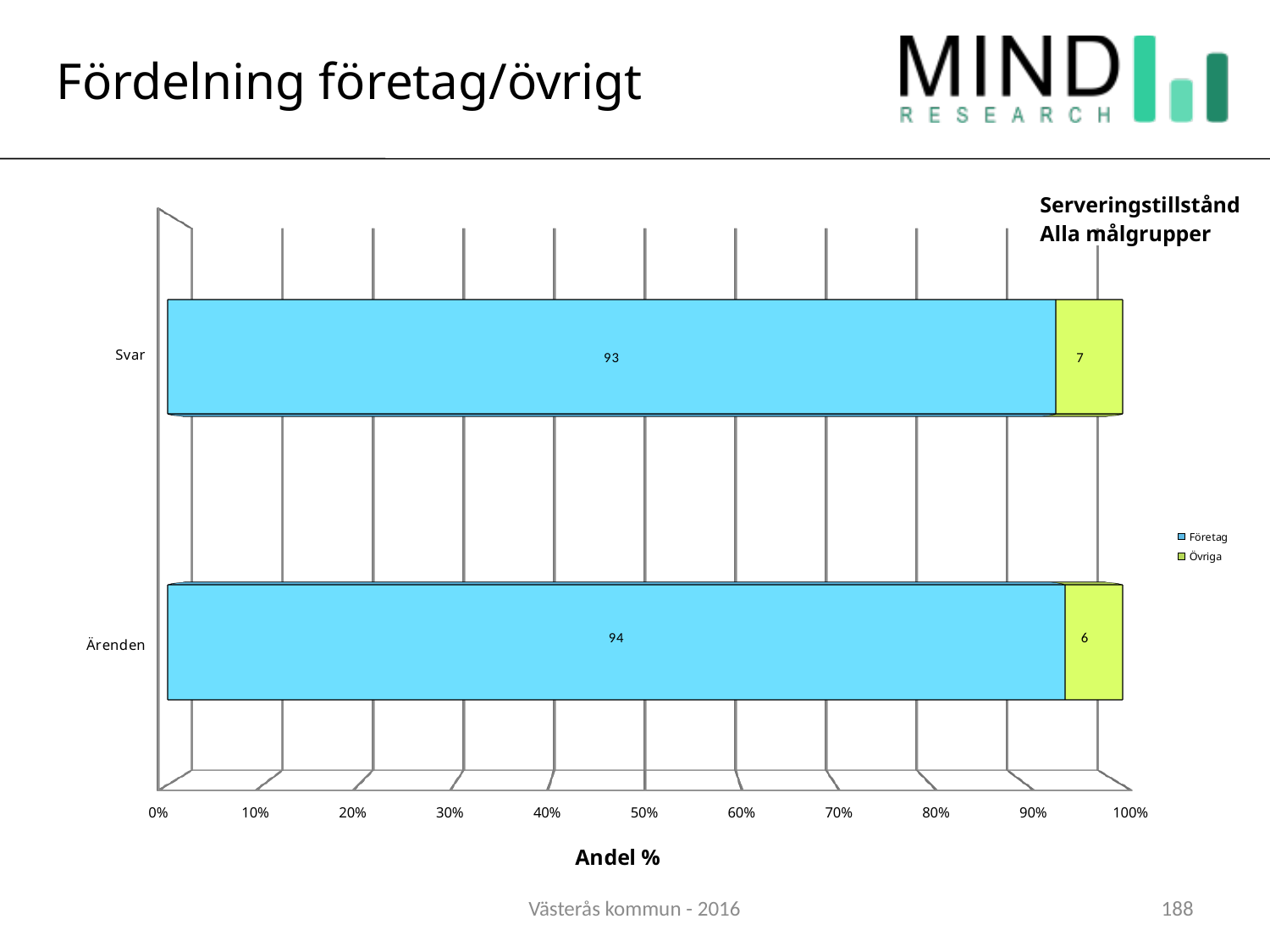
What is the total of the Svar stacked bar? 100 What is the value for Övriga in the Svar bar? 7 What is the difference between the Företag values for Ärenden and Svar? 1 What is the value for Övriga in the Ärenden bar? 6 What is the value for Företag in the Svar bar? 93 What is the value for Företag in the Ärenden bar? 94 What is the label of the horizontal axis? Andel % How many categories are shown on the vertical axis? 2 Which series is shown in light blue? Företag How many series does the legend list? 2 What kind of chart is shown on the slide? Stacked bar chart Which category has the higher Företag value, Svar or Ärenden? Ärenden